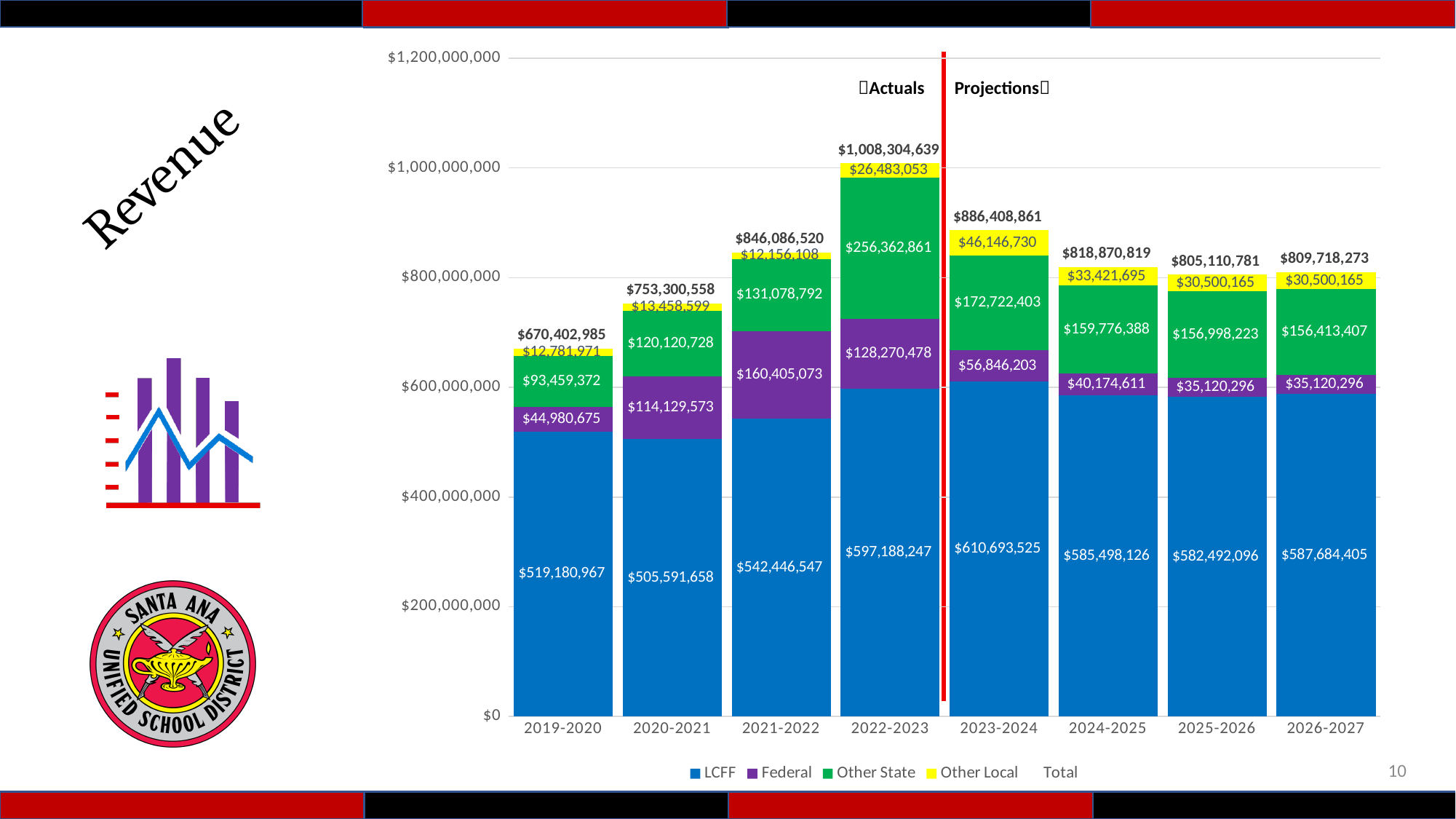
What is the Other Local value for 2019-2020? $12,781,971 What kind of chart is shown on the slide? Stacked bar chart Which is larger, the Federal value for 2020-2021 or the Federal value for 2023-2024? 2020-2021 What is the Other State value for 2023-2024? $172,722,403 How many years are shown on the x axis? 8 What is the LCFF value for 2022-2023? $597,188,247 What is the total revenue for 2022-2023? $1,008,304,639 Which year has the lowest total revenue? 2019-2020 How many series does the legend list? 5 Which year has the highest total revenue? 2022-2023 What is the difference between the total revenue for 2022-2023 and 2021-2022? $162,218,119 What is the Federal value for 2021-2022? $160,405,073